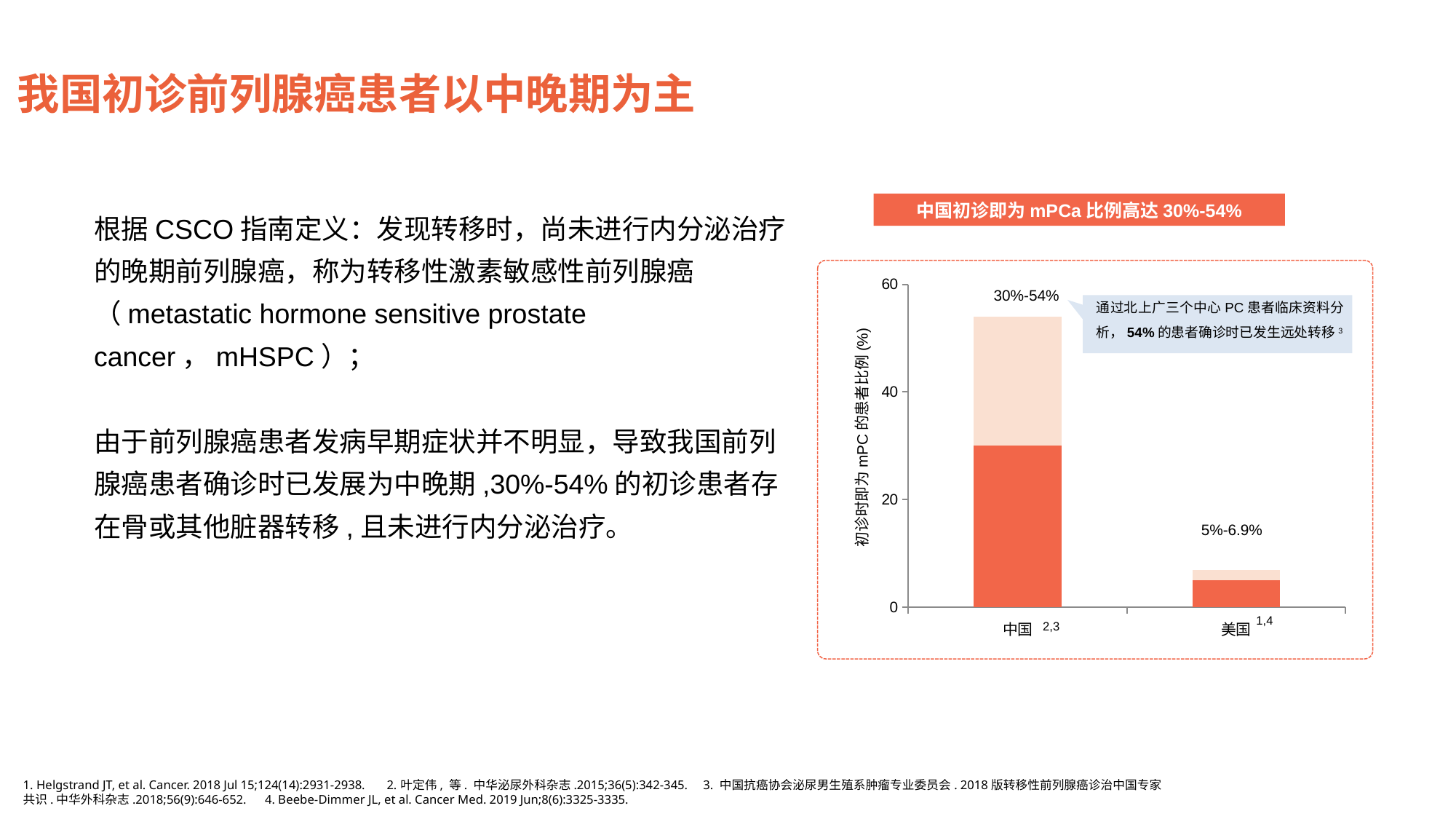
Which category has the highest bar in the chart? 中国 What is the highest tick value shown on the y axis? 60 What range is labelled on the bar for 中国? 30%-54% What kind of chart is shown on the slide? bar chart Do the bar values rise or fall from 中国 to 美国? fall Is the top of the bar for 美国 greater or less than 20? less Is the top of the bar for 中国 greater or less than 40? greater Which category has the higher bar, 中国 or 美国? 中国 How many categories are shown on the x axis of the chart? 2 Which category has the lowest bar in the chart? 美国 What range is labelled on the bar for 美国? 5%-6.9% What is the label of the y axis of the chart? 初诊时即为 mPC 的患者比例 (%)